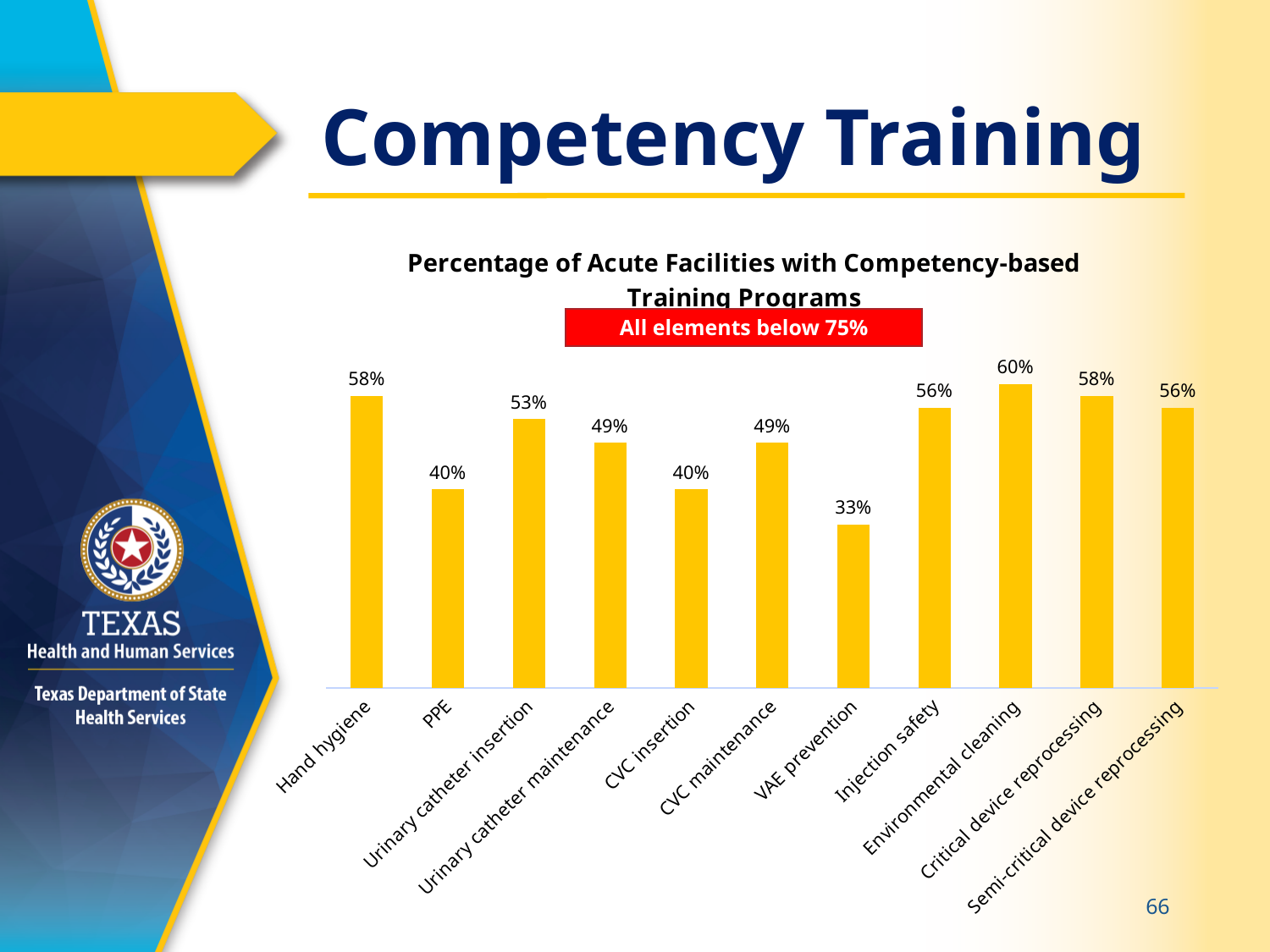
Which is larger, the value for Urinary catheter insertion or the value for CVC insertion? Urinary catheter insertion Which category has the highest percentage? Environmental cleaning What kind of chart is shown on the slide? Bar chart How many categories are shown on the x axis? 11 What is the difference between the values for Injection safety and PPE? 16% What is the value shown for VAE prevention? 33% What is the difference between the values for Environmental cleaning and VAE prevention? 27% What percentage of acute facilities have competency-based training for hand hygiene? 58% What does the red box on the chart say? All elements below 75% What is the value shown for Environmental cleaning? 60% What is the title of the chart? Percentage of Acute Facilities with Competency-based Training Programs Which category has the lowest percentage? VAE prevention